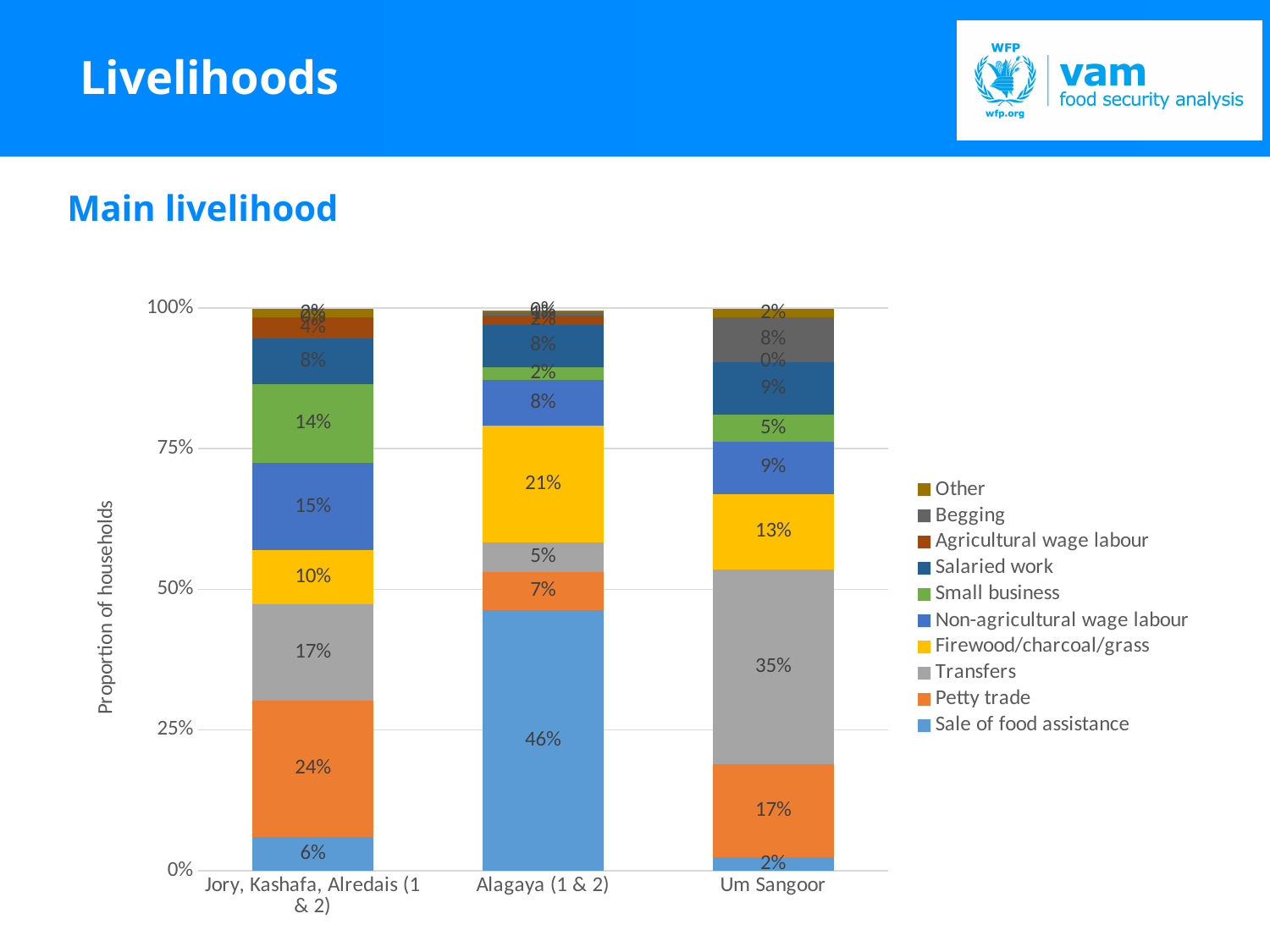
Which is larger: Small business in Jory, Kashafa, Alredais (1 & 2) or Small business in Um Sangoor? Jory, Kashafa, Alredais (1 & 2) How many series does the legend list? 10 What is the difference between Petty trade in Jory, Kashafa, Alredais (1 & 2) and Petty trade in Um Sangoor? 7% What is the value for Sale of food assistance in Alagaya (1 & 2)? 46% Which location has the highest value for Sale of food assistance? Alagaya (1 & 2) What is the value for Petty trade in Jory, Kashafa, Alredais (1 & 2)? 24% Which location has the lowest value for Transfers? Alagaya (1 & 2) What kind of chart is shown on the slide? Stacked bar chart How many location categories are shown on the x axis? 3 What is the value for Firewood/charcoal/grass in Alagaya (1 & 2)? 21% What is the value for Transfers in Um Sangoor? 35% What is the label of the y axis? Proportion of households